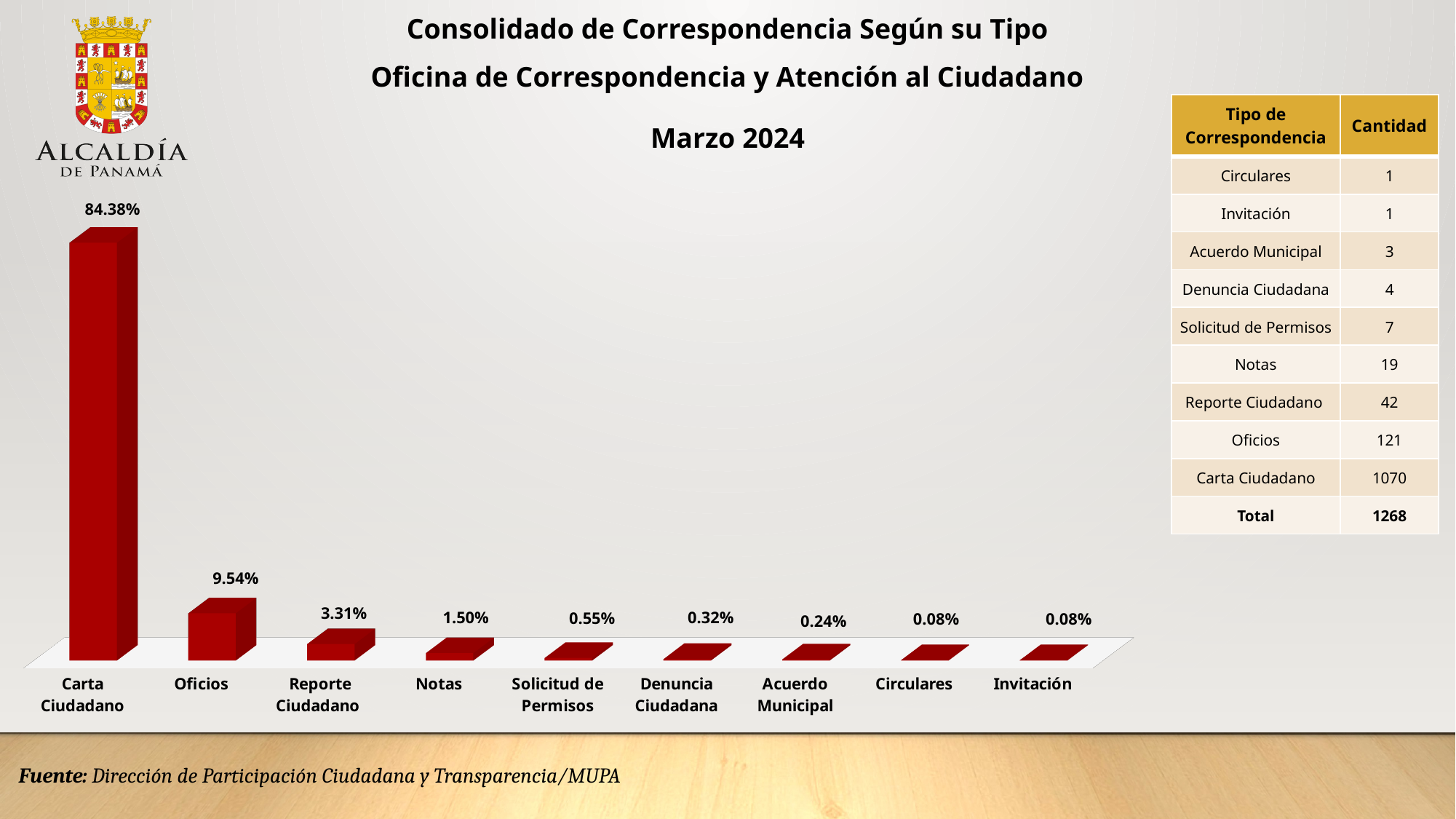
Do the bar values rise or fall from left to right along the x axis? Fall How many categories are shown on the x axis of the chart? 9 What percentage does the bar for Oficios show? 9.54% What colour are the bars in the chart? Dark red What percentage does the bar for Notas show? 1.50% What percentage does the bar for Carta Ciudadano show? 84.38% Which has a larger percentage, Solicitud de Permisos or Acuerdo Municipal? Solicitud de Permisos What is the difference in percentage points between Oficios and Reporte Ciudadano? 6.23% What is the difference in percentage points between Carta Ciudadano and Oficios? 74.84% What percentage does the bar for Denuncia Ciudadana show? 0.32% What kind of chart is shown on the slide? Bar chart Which category has the highest percentage in the chart? Carta Ciudadano